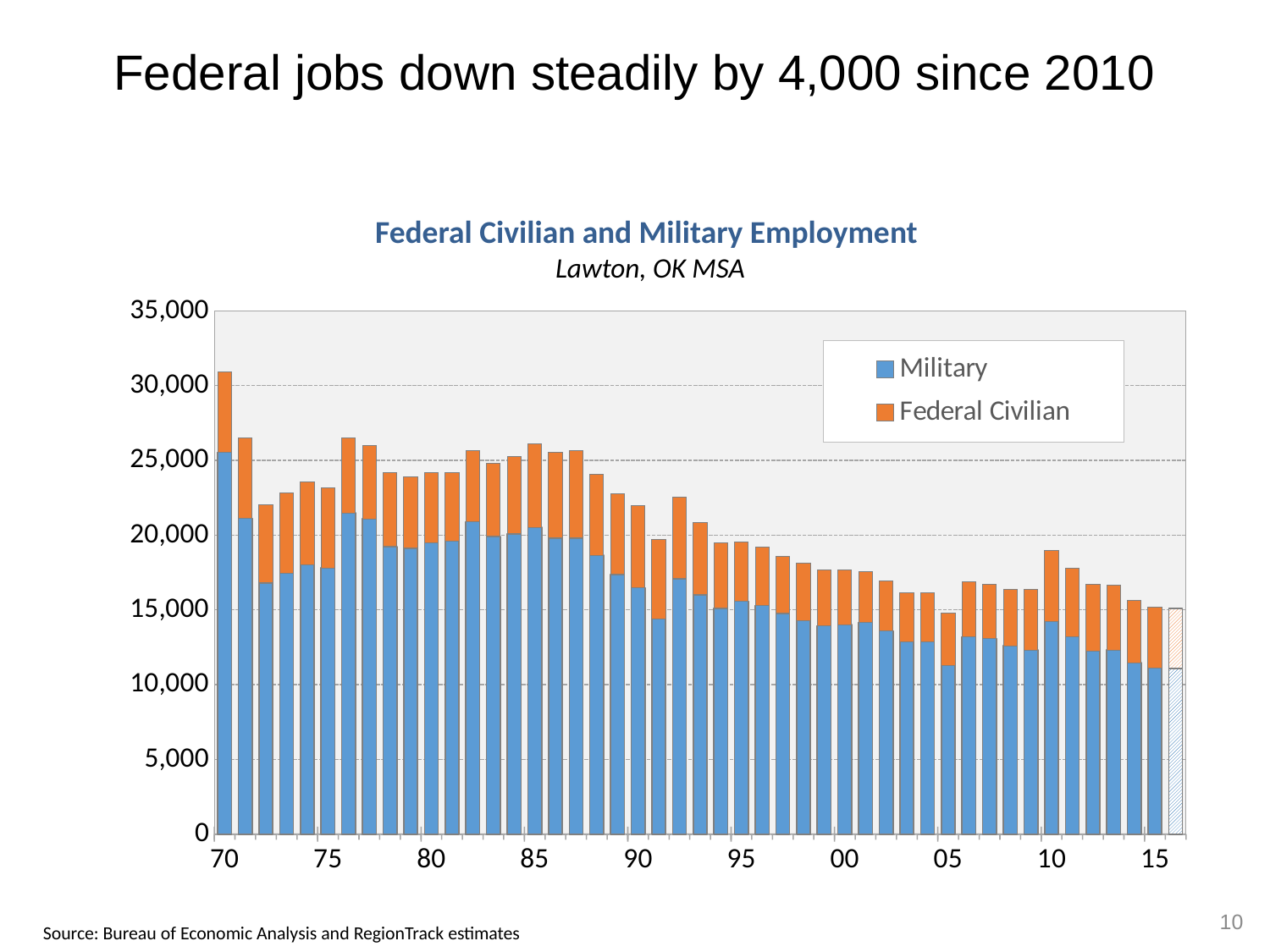
Is the total employment for 1990 greater or less than 20,000? greater Which year has the highest total federal civilian and military employment? 1970 Is the Military value for 1976 greater or less than 20,000? greater Do total employment values generally rise or fall from 1970 to 2015? fall Which two series are shown in the legend? Military and Federal Civilian Is the total employment for 1970 greater or less than 30,000? greater Which is larger, the Military value in 1985 or in 1995? 1985 Which colour represents the Military series? blue Which is larger, the total employment in 1970 or in 1980? 1970 How many series does the legend list? 2 What kind of chart is shown on the slide? stacked bar chart